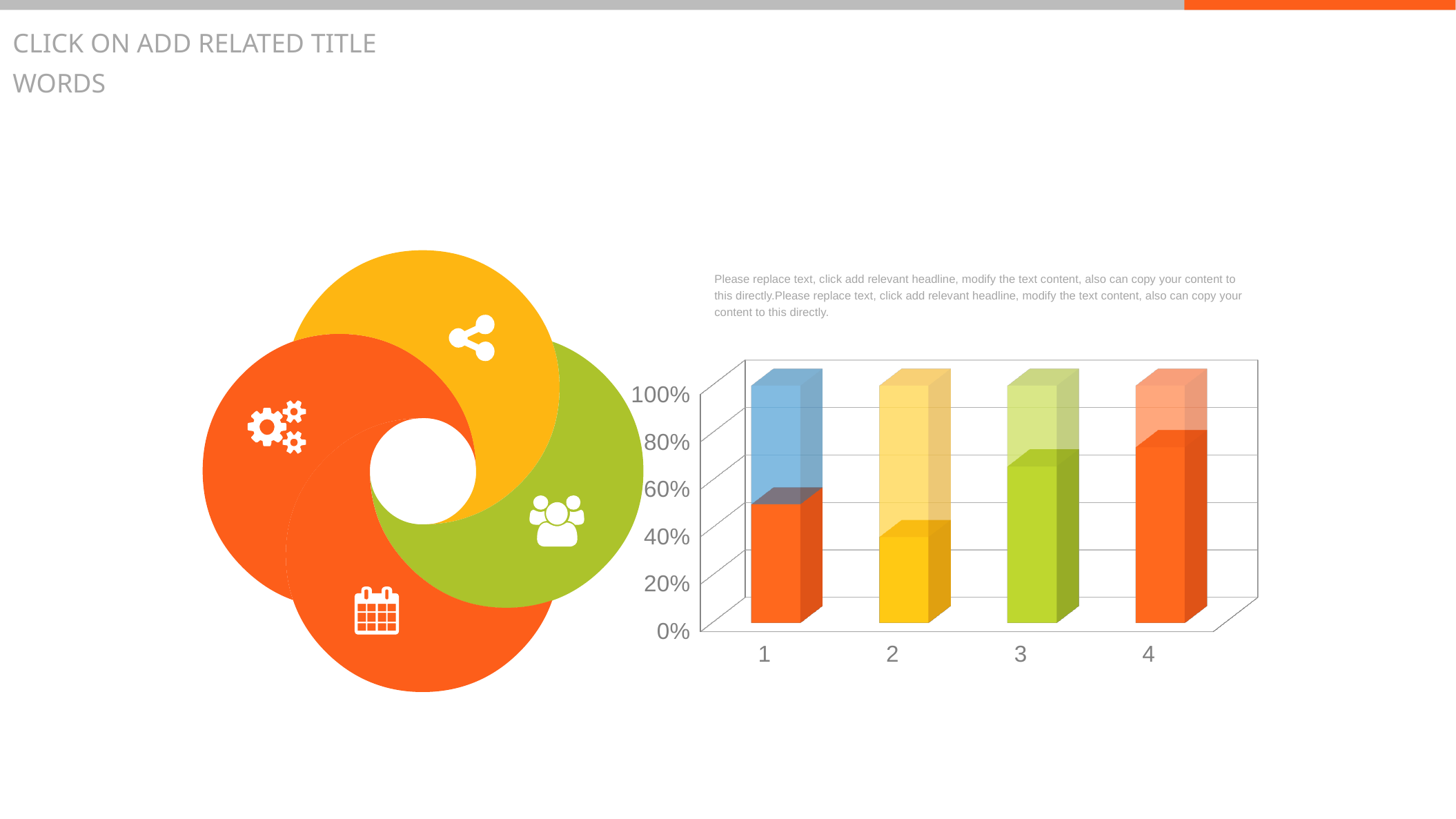
What is the highest value labelled on the y axis of the chart? 100% Is the value for category 1 greater or less than 40%? greater Is the value for category 2 greater or less than 60%? less What kind of chart is shown on the right of the slide? bar chart Is the value for category 4 greater or less than 60%? greater How many categories are shown on the x axis of the bar chart? 4 Which category has the shortest solid bar in the chart? 2 What colour is the solid bar for category 3? green Is the solid bar for category 3 taller or shorter than the solid bar for category 1? taller Is the solid bar for category 2 taller or shorter than the solid bar for category 4? shorter Which category has the tallest solid bar in the chart? 4